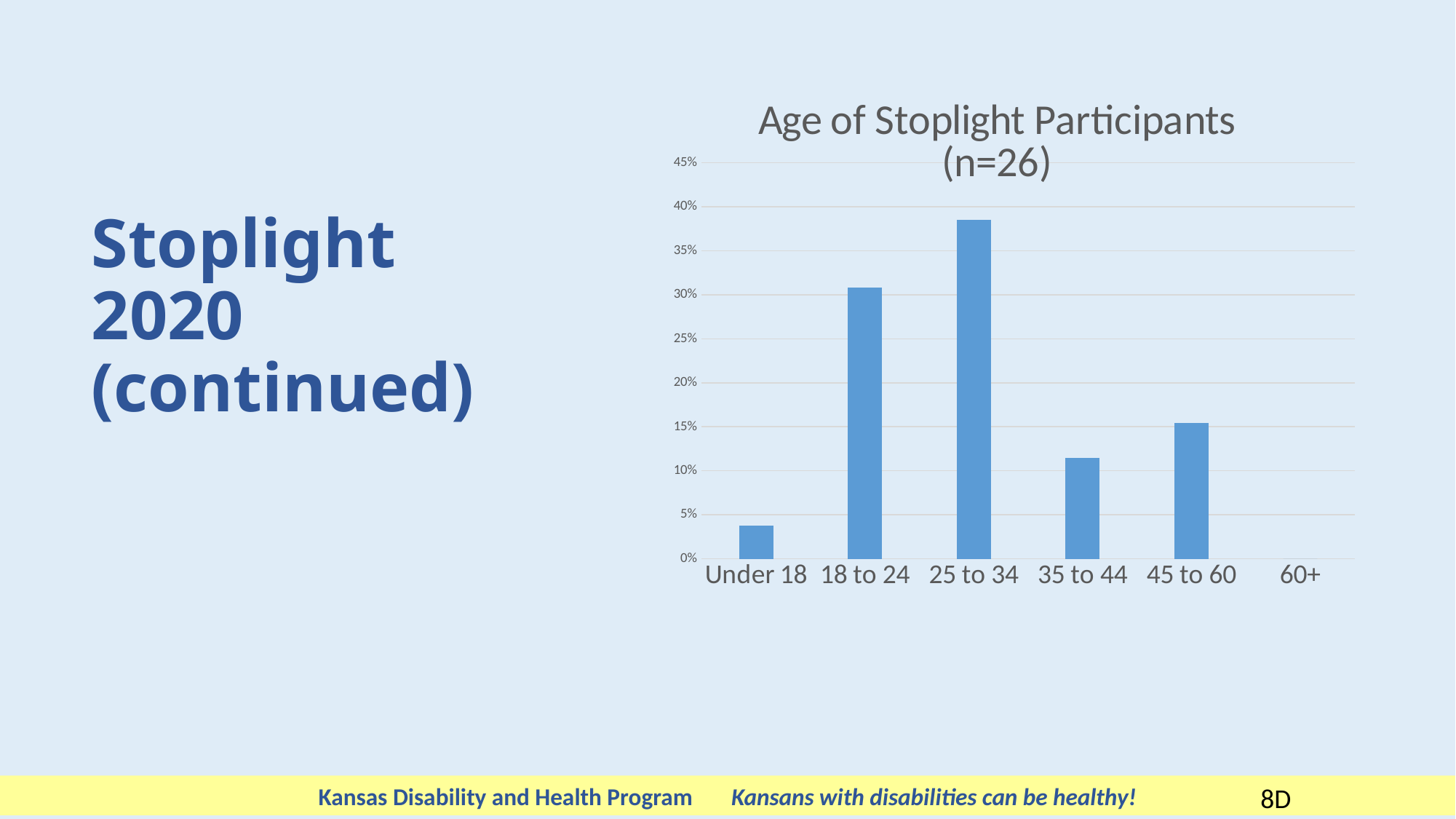
Is the value for Under 18 greater or less than 5%? less How many participants does the chart title say were included (n)? 26 How many age categories are shown on the x axis of the chart? 6 Which age category has the lowest share of Stoplight participants? 60+ Is the value for 35 to 44 greater or less than 10%? greater What is the title of the chart? Age of Stoplight Participants (n=26) What kind of chart is shown on the slide? bar chart Is the value for 18 to 24 greater or less than 25%? greater Which age category has the highest share of Stoplight participants? 25 to 34 Which has a larger share of participants, 45 to 60 or 35 to 44? 45 to 60